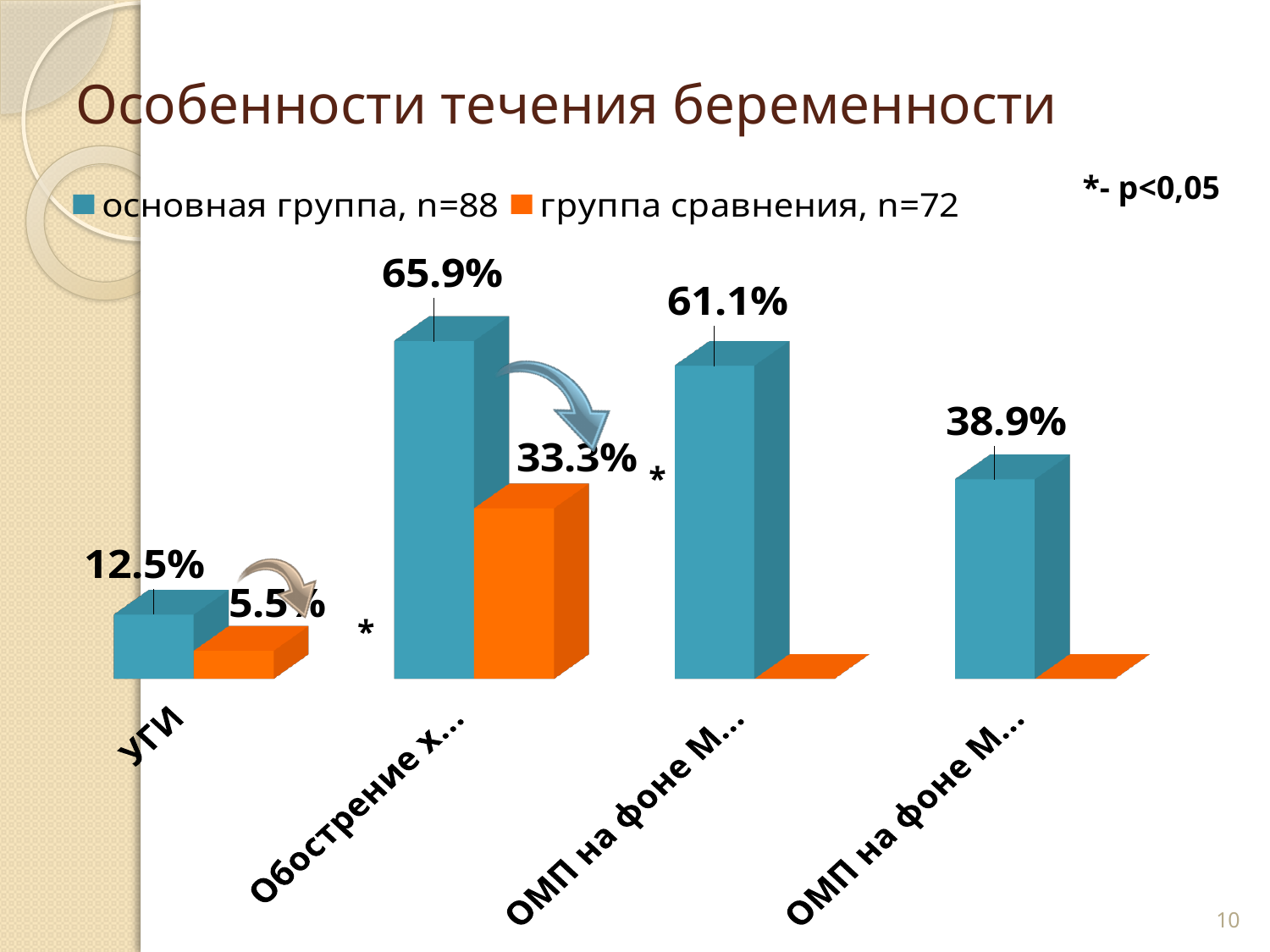
Which is larger: the основная группа value in the third category or in the fourth category? The third category (61.1%) What kind of chart is shown on the slide? Bar chart What is the value for основная группа in the УГИ category? 12.5% How many series does the legend list? 2 What is the value for группа сравнения in the second category (Обострение х...)? 33.3% What is the value for основная группа in the third category from the left? 61.1% What is the value for основная группа in the fourth (rightmost) category? 38.9% Which category has the lowest value for основная группа? УГИ What is the value for основная группа in the second category (Обострение х...)? 65.9% Which category has the highest value for основная группа? Обострение х... (second category) What is the value for группа сравнения in the УГИ category? 5.5% What is the difference between основная группа and группа сравнения in the second category (Обострение х...)? 32.6 percentage points